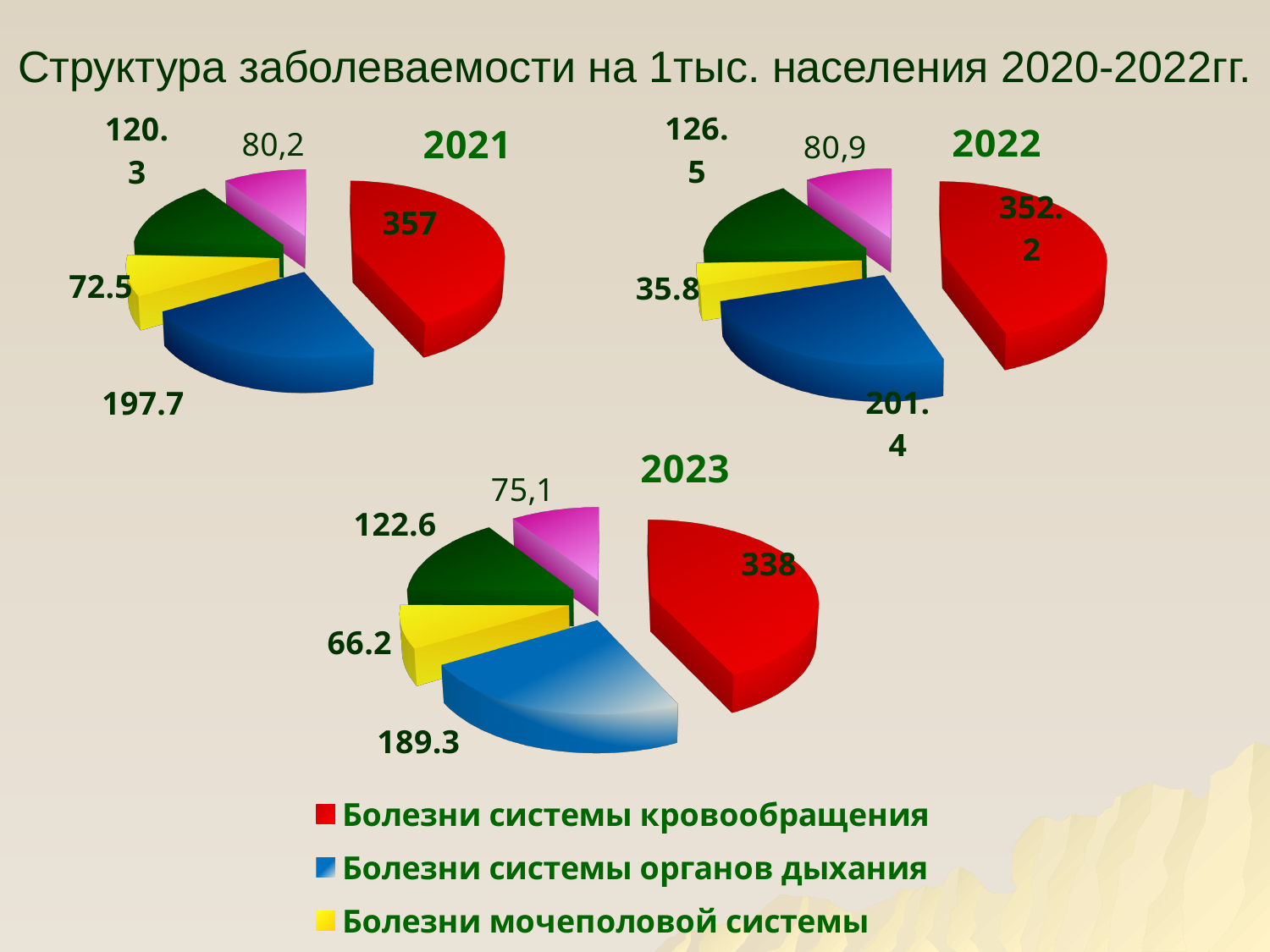
Which colour represents Болезни системы органов дыхания in the legend? Blue In the 2023 pie chart, which is larger: Болезни системы органов дыхания or Болезни мочеполовой системы? Болезни системы органов дыхания In the 2022 pie chart, what is the value for Болезни системы органов дыхания? 201.4 In the 2021 pie chart, what is the difference between the values for Болезни системы кровообращения and Болезни системы органов дыхания? 159.3 In the 2021 pie chart, what is the value for Болезни системы кровообращения? 357 Which is larger: the value for Болезни системы кровообращения in the 2021 chart or in the 2023 chart? 2021 In the 2023 pie chart, which category has the largest slice? Болезни системы кровообращения How many slices does the 2022 pie chart have? 5 In the 2023 pie chart, what is the value for Болезни мочеполовой системы? 66.2 In the 2022 pie chart, which category has the smallest slice? Болезни мочеполовой системы What type of chart is used for the 2021 data? Pie chart In the 2022 pie chart, what is the value for Болезни мочеполовой системы? 35.8